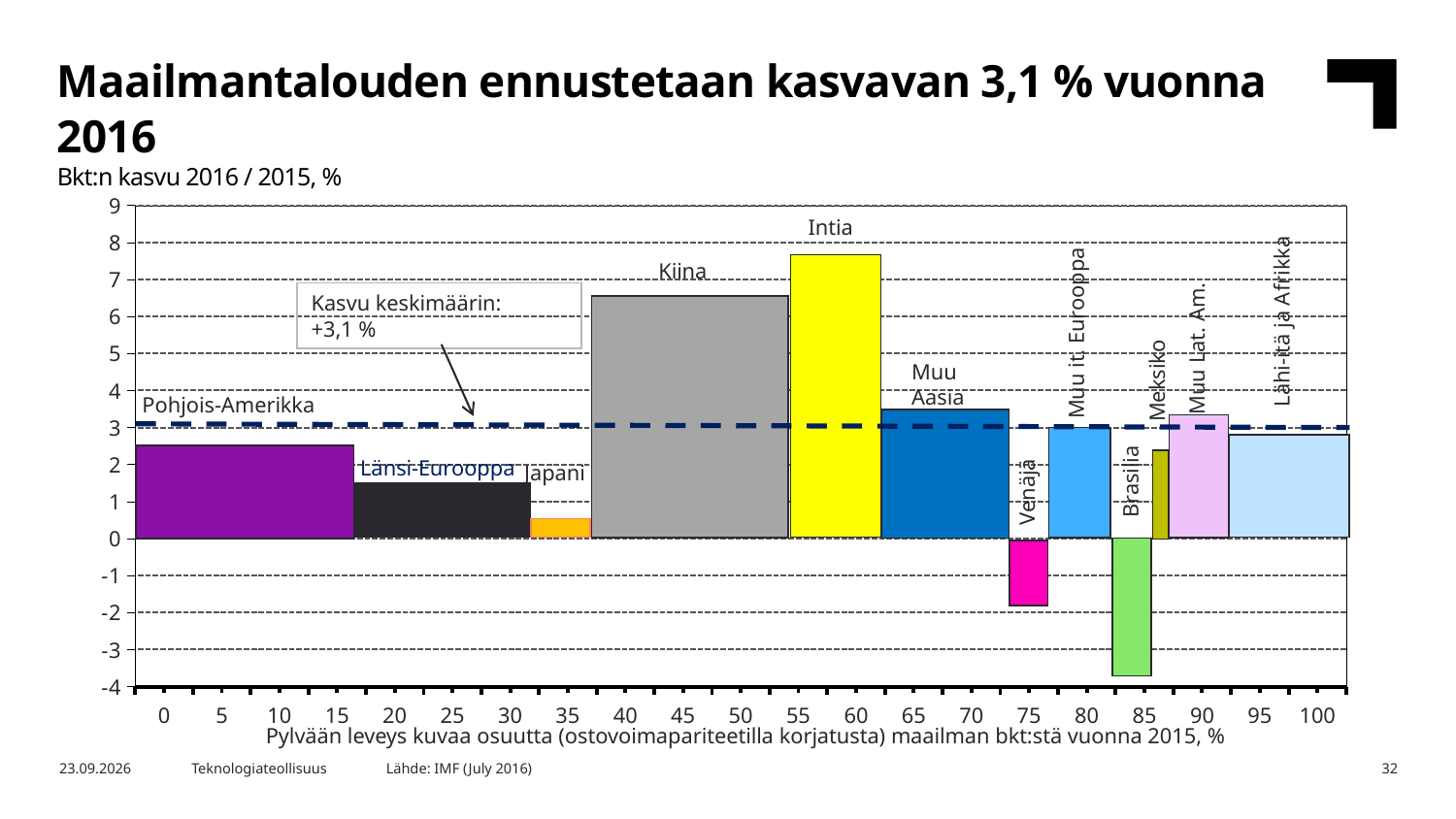
Which has the larger GDP growth, Kiina or Intia? Intia Which region has the lowest GDP growth in the chart? Brasilia Which has the larger GDP growth, Venäjä or Brasilia? Venäjä Is the value for Venäjä greater or less than 0? less Which region has the highest GDP growth in the chart? Intia Is the value for Japani greater or less than 1? less What average growth value is marked by the dashed line in the chart? +3,1 % How many regions show negative GDP growth in the chart? 2 How many regions are shown as bars in the chart? 12 Is the value for Pohjois-Amerikka greater or less than 3? less What kind of chart is shown on the slide? bar chart